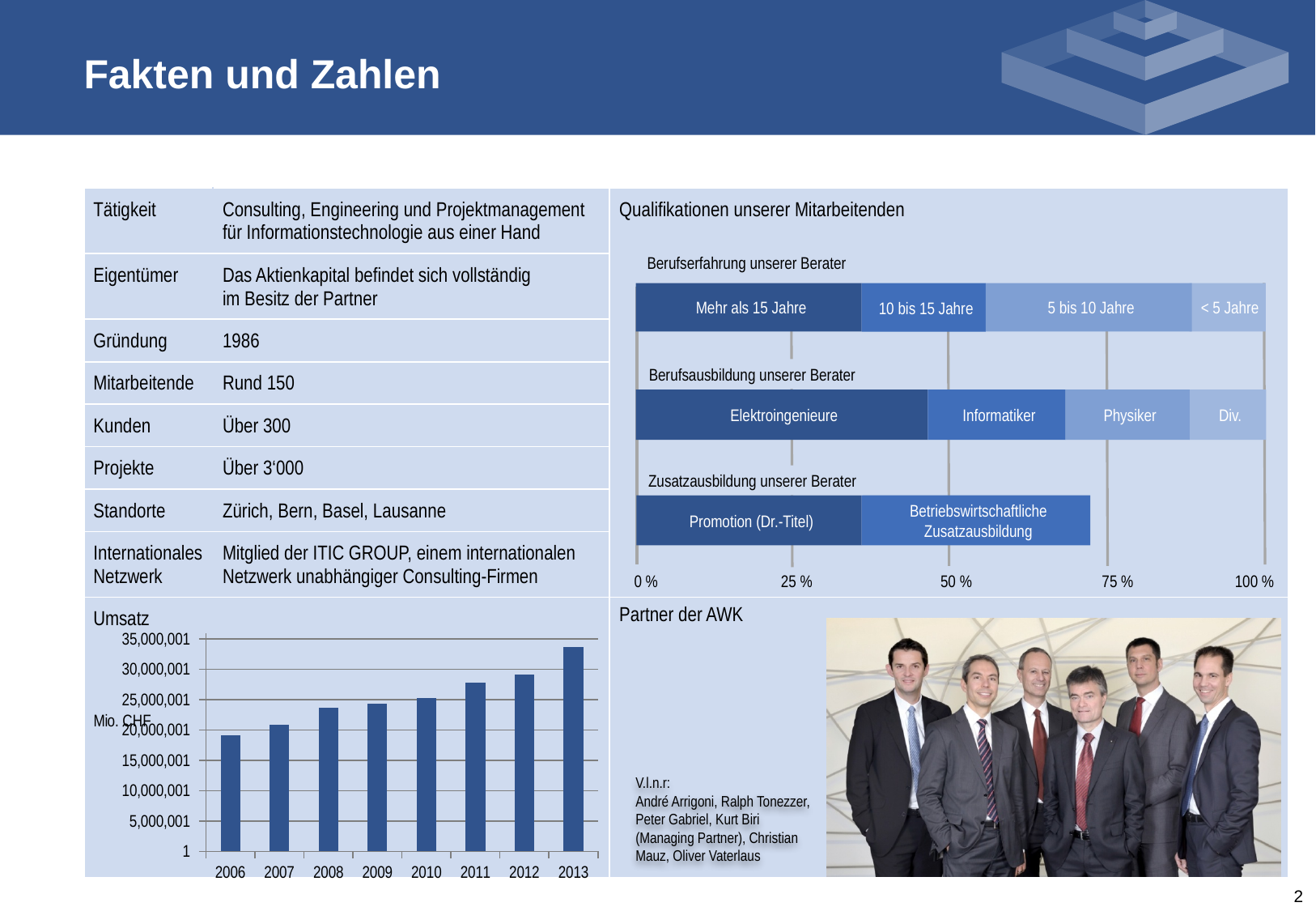
In the Umsatz chart, do the values rise or fall from 2006 to 2013? rise What kind of chart is the Umsatz chart at the bottom left of the slide? bar chart In the Berufserfahrung unserer Berater bar of the Qualifikationen chart, which segment is the smallest? < 5 Jahre In the Qualifikationen chart, is the share of the '< 5 Jahre' segment greater or less than 25 %? less In the Umsatz chart, which is larger, the value for 2012 or the value for 2009? 2012 In the Berufsausbildung unserer Berater bar of the Qualifikationen chart, which segment is the largest? Elektroingenieure In the Umsatz chart, which year has the highest value? 2013 In the Umsatz chart, is the value for 2006 greater or less than 25,000,001? less How many segments does the Zusatzausbildung unserer Berater bar of the Qualifikationen chart contain? 2 How many years are shown on the x axis of the Umsatz chart? 8 In the Umsatz chart, which year has the lowest value? 2006 In the Umsatz chart, is the value for 2013 greater or less than 30,000,001? greater